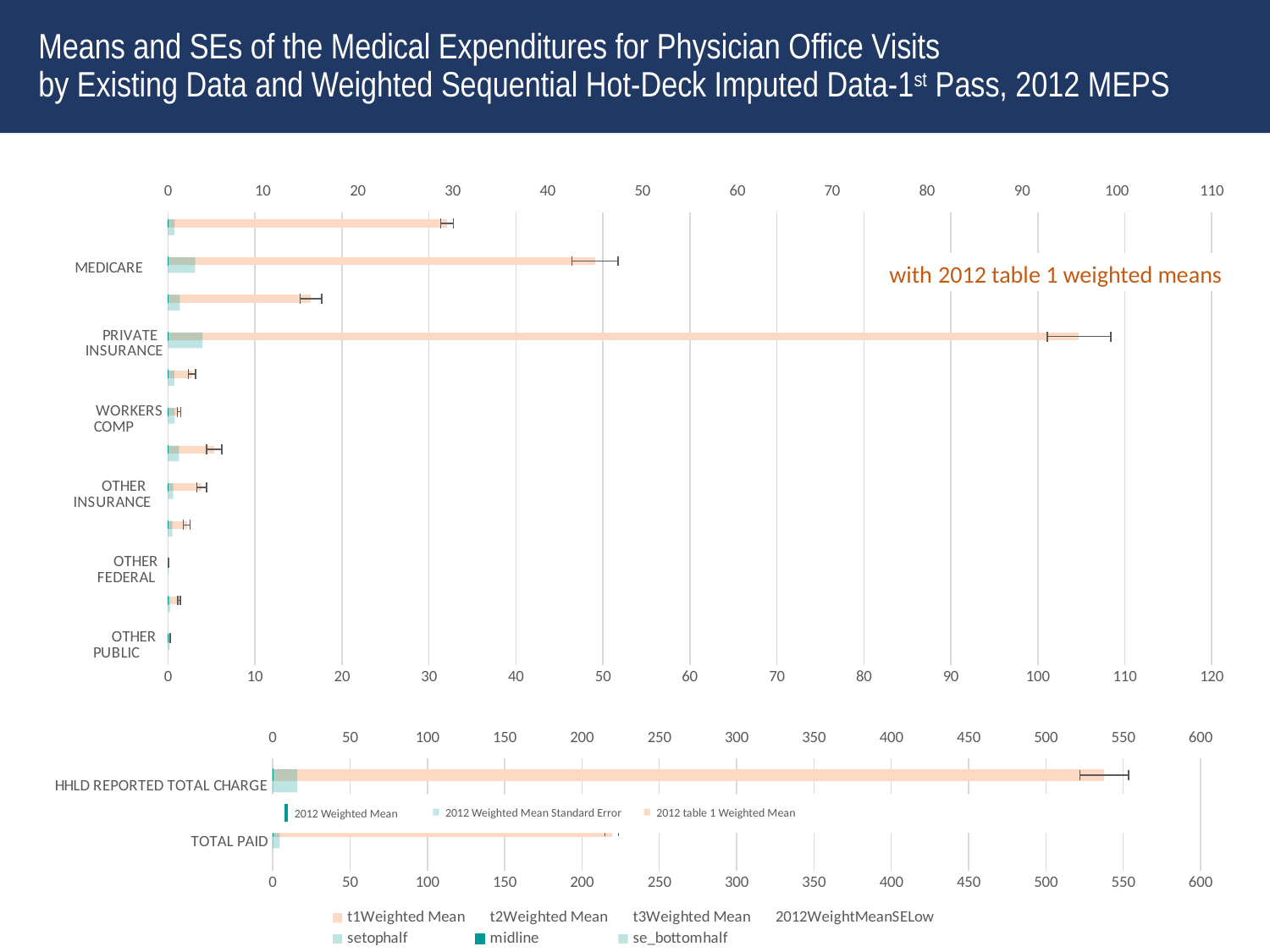
What kind of chart is the top chart on the slide? bar chart In the bottom chart, which category has the longer bar, HHLD REPORTED TOTAL CHARGE or TOTAL PAID? HHLD REPORTED TOTAL CHARGE In the top chart, which has longer bars, MEDICARE or WORKERS COMP? MEDICARE In the bottom chart, how many categories are labelled on the vertical axis? 2 In the bottom chart, is the value for HHLD REPORTED TOTAL CHARGE greater or less than 500? greater In the top chart, is the longest bar for PRIVATE INSURANCE greater or less than 90? greater In the bottom chart, what is the highest value shown on the horizontal axis? 600 What orange annotation text appears in the top chart? with 2012 table 1 weighted means In the top chart, which category has the longest bar? PRIVATE INSURANCE How many entries does the legend at the very bottom of the slide list? 7 In the top chart, how many categories are labelled on the vertical axis? 6 In the bottom chart, is the value for TOTAL PAID greater or less than 250? less